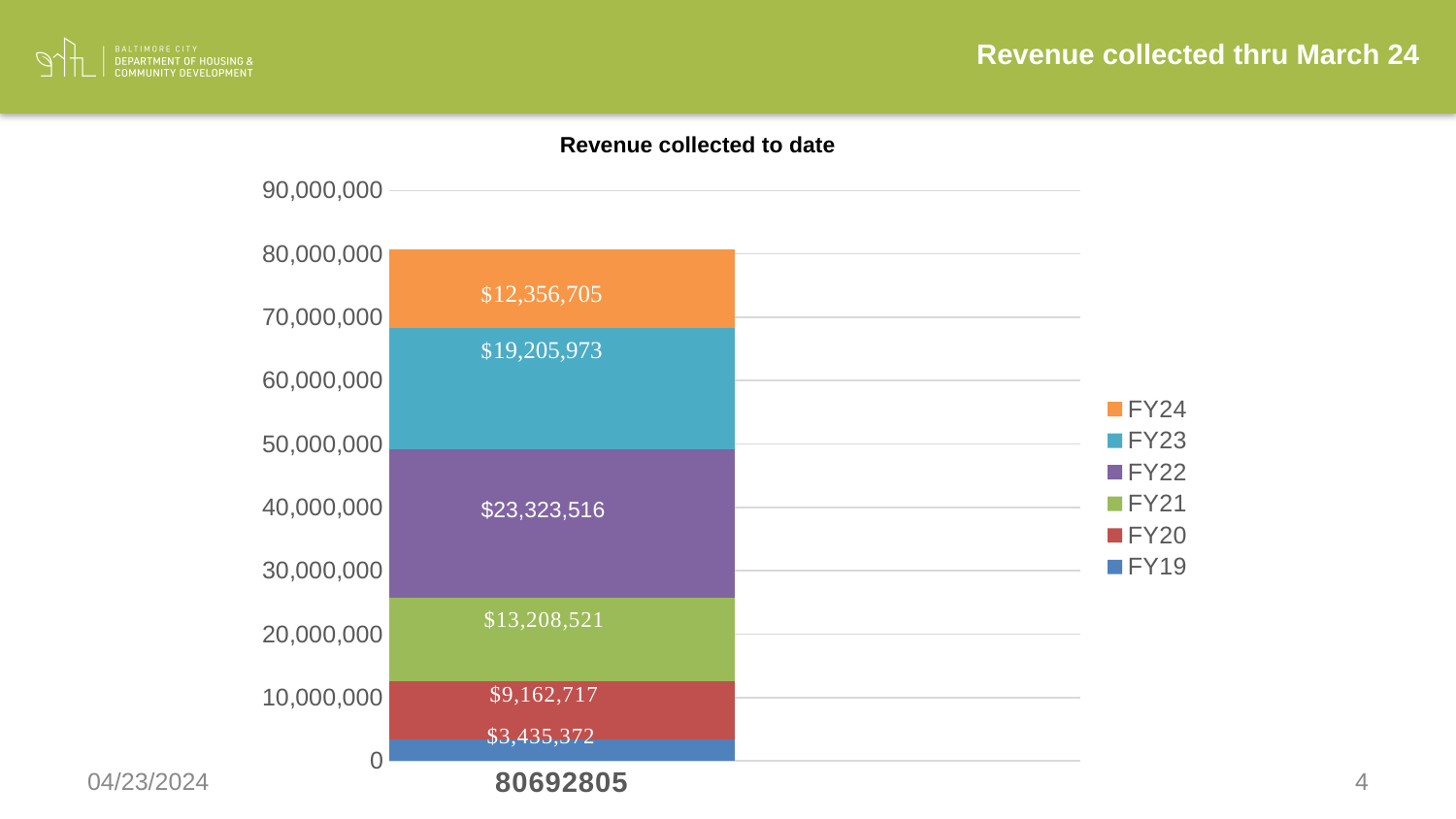
What is the difference between the FY22 and FY23 segments? $4,117,543 How many bars are plotted in the chart? 1 What is the title of the chart? Revenue collected to date What is the value of the FY22 segment? $23,323,516 How many series does the legend list? 6 Which is larger, the FY21 segment or the FY24 segment? FY21 Is the top of the stacked bar greater or less than 80,000,000? greater Which fiscal year has the largest segment in the bar? FY22 What kind of chart is shown on the slide? stacked bar chart What is the value of the FY24 segment? $12,356,705 What is the value of the FY19 segment? $3,435,372 Which fiscal year has the smallest segment in the bar? FY19